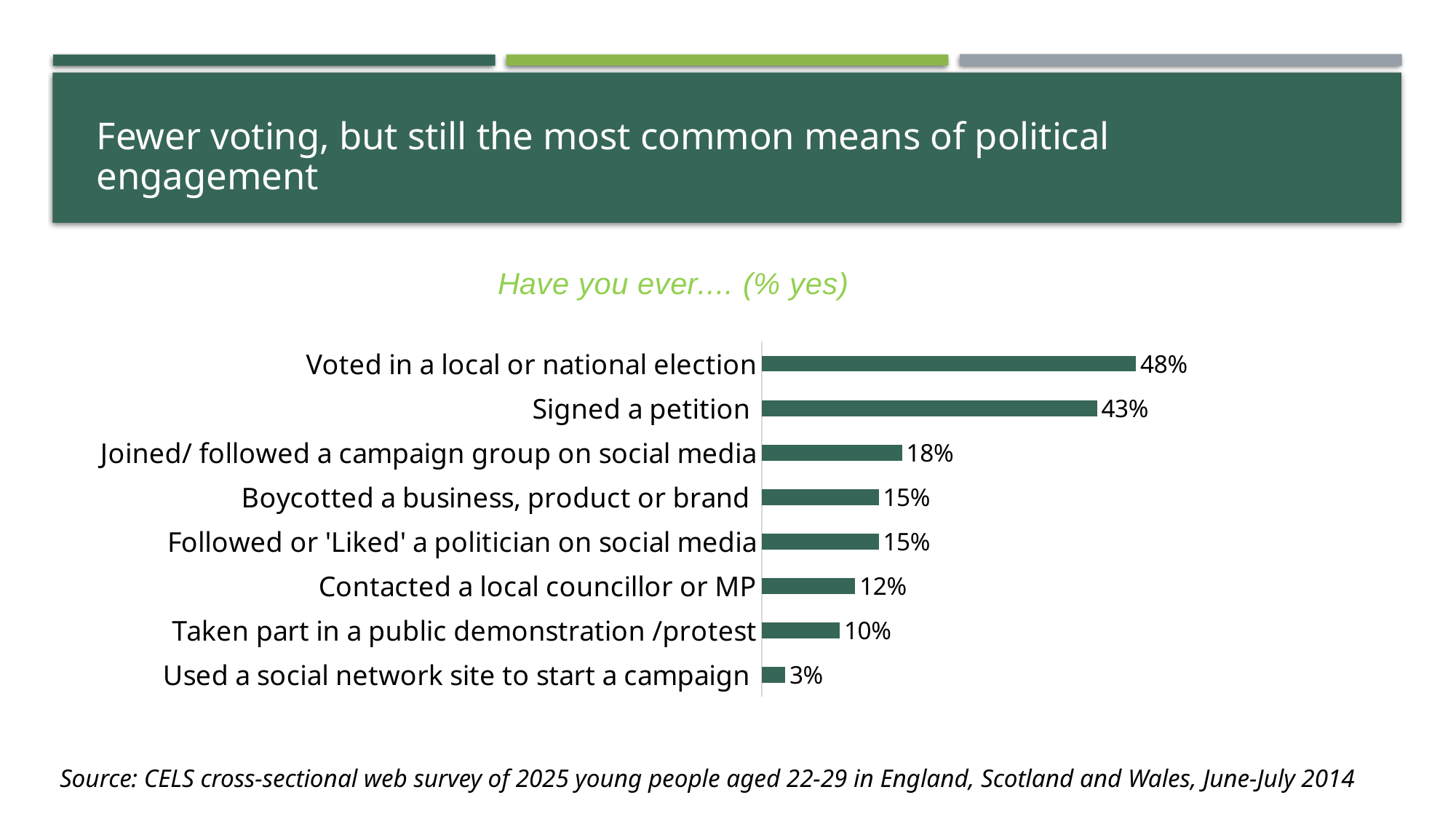
What is the value for 'Contacted a local councillor or MP'? 12% Which activity has the lowest percentage of 'yes' responses? Used a social network site to start a campaign What is the value for 'Used a social network site to start a campaign'? 3% What percentage of respondents said they had voted in a local or national election? 48% What kind of chart is shown on the slide? Bar chart What is the title of the chart? Have you ever…. (% yes) What is the difference in percentage points between 'Voted in a local or national election' and 'Signed a petition'? 5 How many activities are shown in the chart? 8 What is the difference in percentage points between 'Joined/ followed a campaign group on social media' and 'Taken part in a public demonstration /protest'? 8 Which activity has the highest percentage of 'yes' responses? Voted in a local or national election Which is larger: the value for 'Joined/ followed a campaign group on social media' or the value for 'Contacted a local councillor or MP'? Joined/ followed a campaign group on social media What percentage of respondents said they had signed a petition? 43%